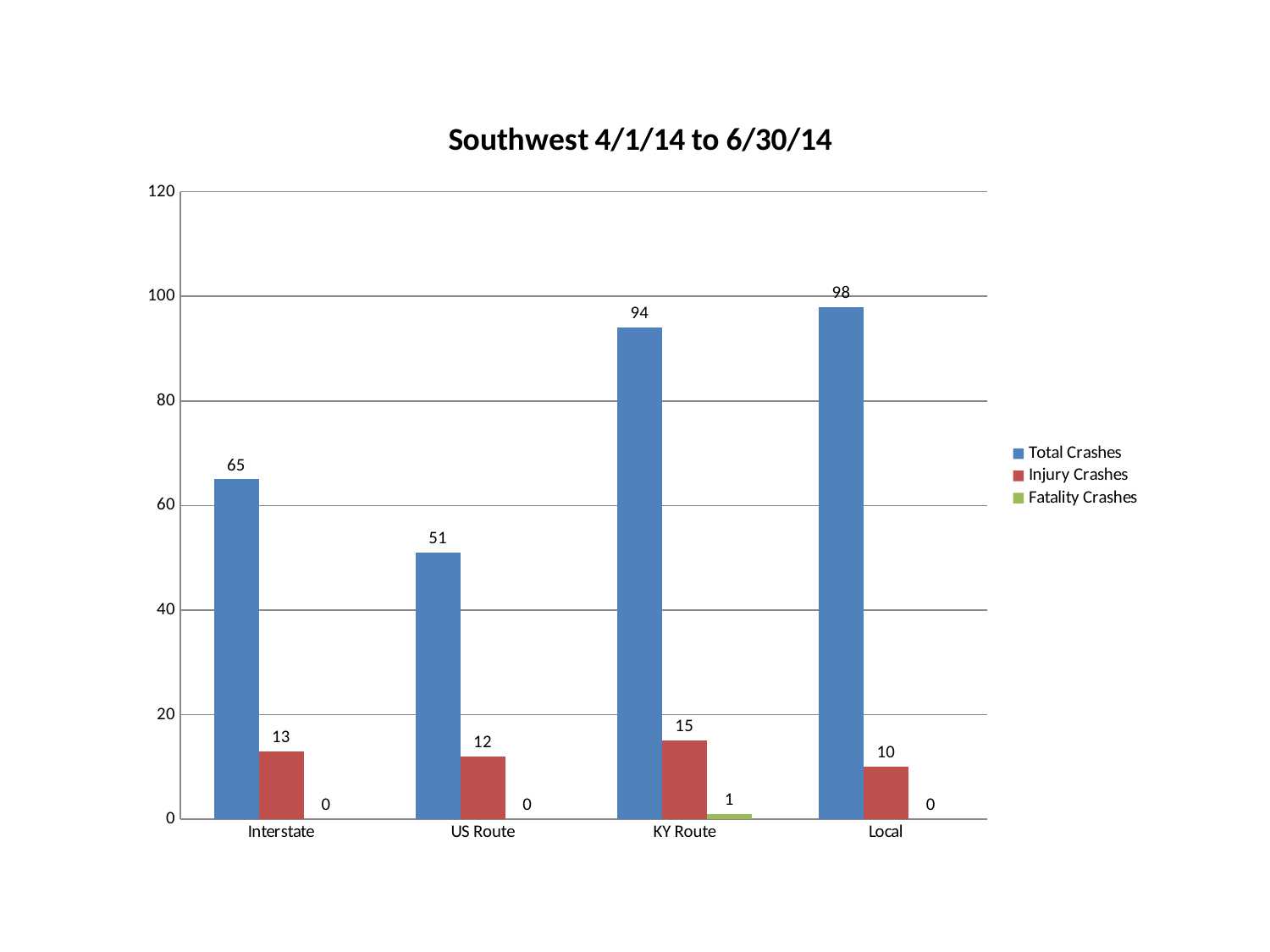
Which is larger, Injury Crashes for KY Route or Injury Crashes for Local? KY Route What is the value of Total Crashes for KY Route? 94 How many categories are shown on the x axis? 4 What is the value of Fatality Crashes for KY Route? 1 What is the difference between Total Crashes for Local and Total Crashes for US Route? 47 Which category has the highest Total Crashes? Local How many series does the legend list? 3 Which category has the lowest Total Crashes? US Route Is the value of Total Crashes for Interstate greater or less than 60? greater What is the title of the chart? Southwest 4/1/14 to 6/30/14 What kind of chart is shown on the slide? bar chart What is the value of Injury Crashes for Interstate? 13